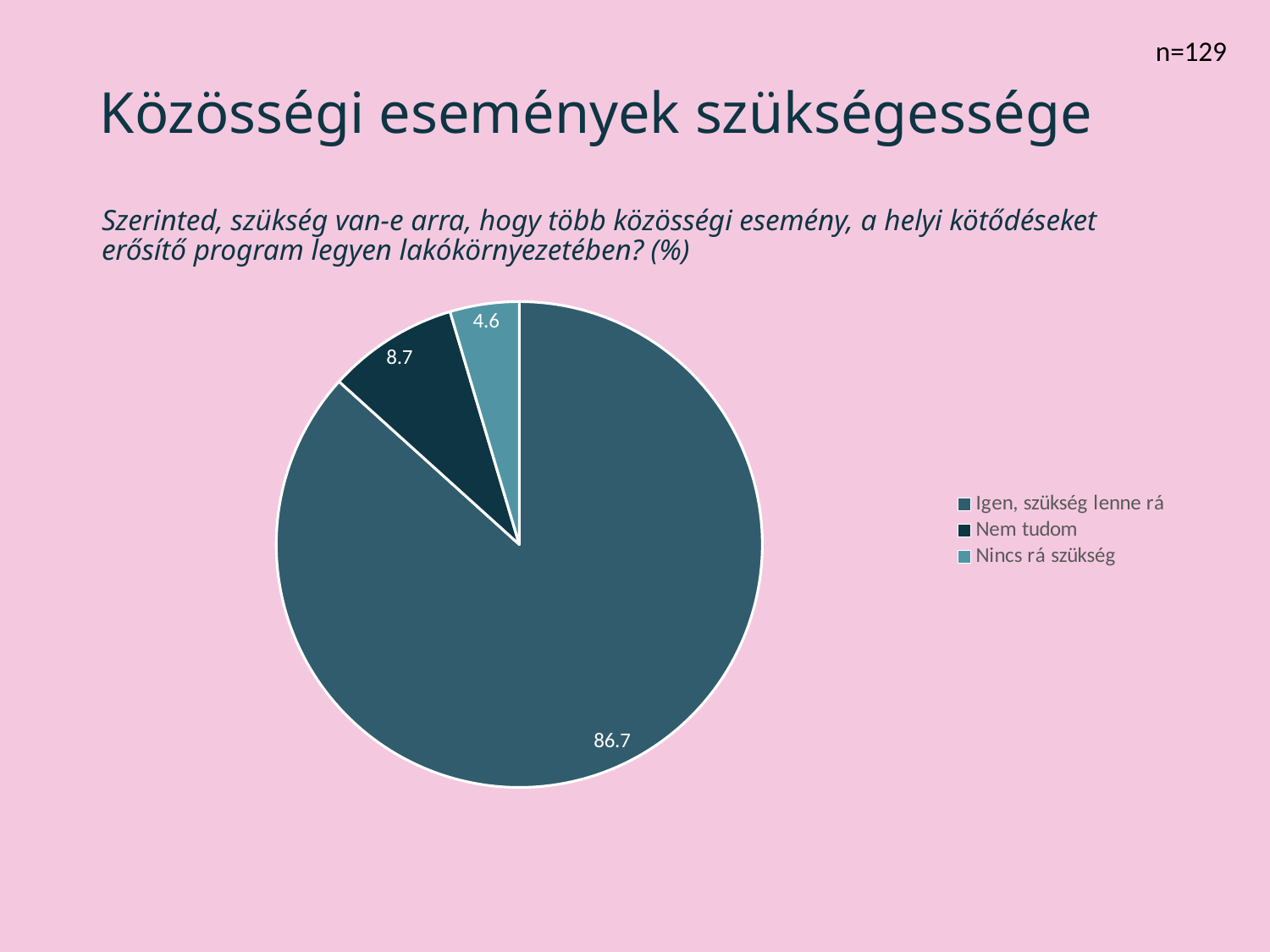
What is the value for "Igen, szükség lenne rá"? 86.7 What is the value for "Nem tudom"? 8.7 Which category has the largest slice? Igen, szükség lenne rá Which category has the smallest slice? Nincs rá szükség What sample size (n) is shown on the slide? n=129 What kind of chart is shown on the slide? pie chart What is the difference between the values for "Nem tudom" and "Nincs rá szükség"? 4.1 What is the difference between the values for "Igen, szükség lenne rá" and "Nem tudom"? 78.0 What is the value for "Nincs rá szükség"? 4.6 Which is larger, the value for "Nem tudom" or the value for "Nincs rá szükség"? Nem tudom How many entries does the legend list? 3 How many slices does the pie chart have? 3